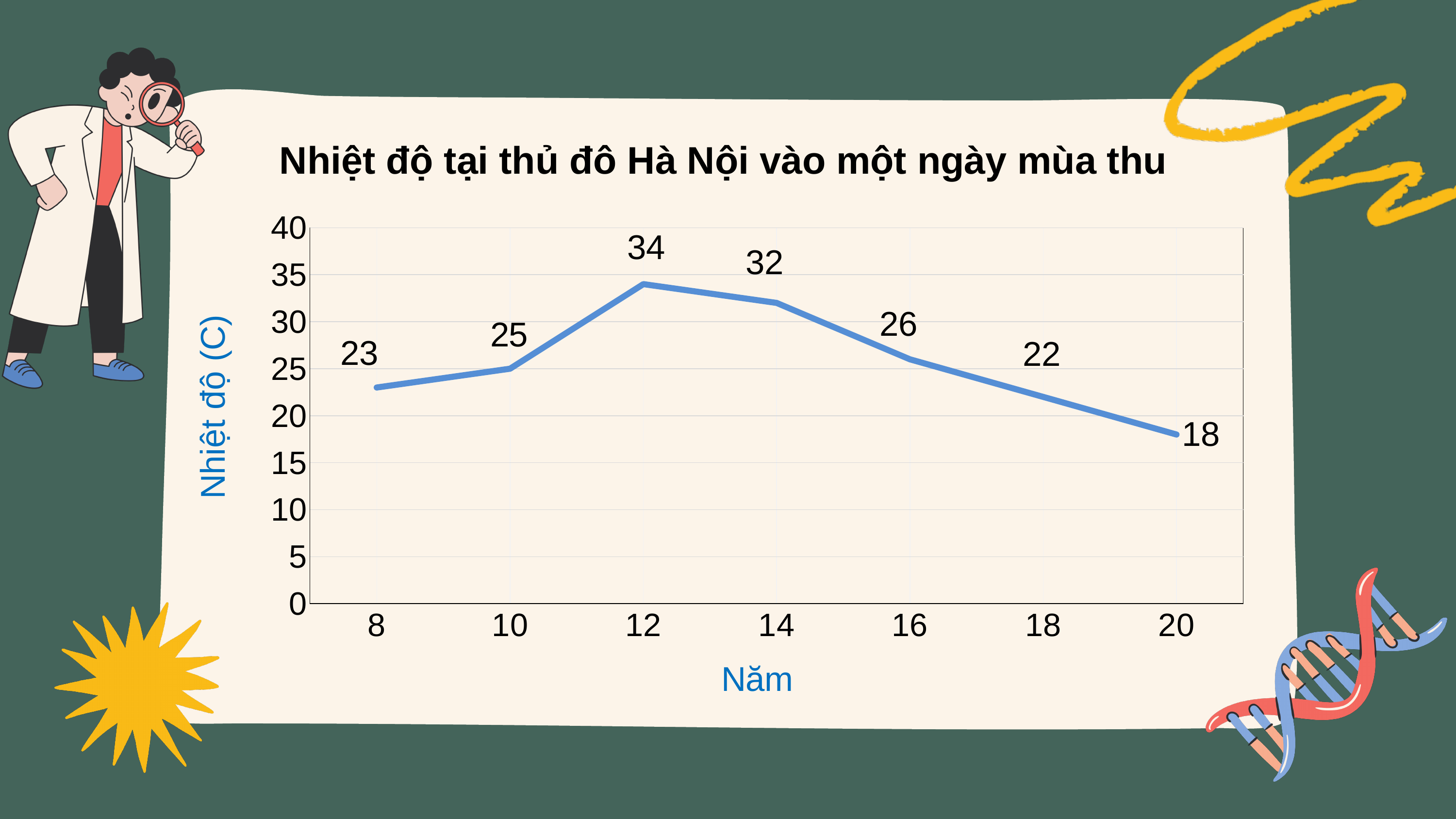
What is the difference between the temperature at 12 and the temperature at 20? 16 What kind of chart is shown on the slide? line chart At which x-axis value is the temperature highest? 12 How many data points are plotted on the line? 7 What is the title of the chart? Nhiệt độ tại thủ đô Hà Nội vào một ngày mùa thu What is the temperature at 20 on the x axis? 18 What is the temperature at 12 on the x axis? 34 Which is larger, the temperature at 10 or the temperature at 18? 10 At which x-axis value is the temperature lowest? 20 What is the difference between the temperature at 14 and the temperature at 16? 6 What is the temperature at 8 on the x axis? 23 Does the temperature rise or fall from 12 to 20 on the x axis? fall